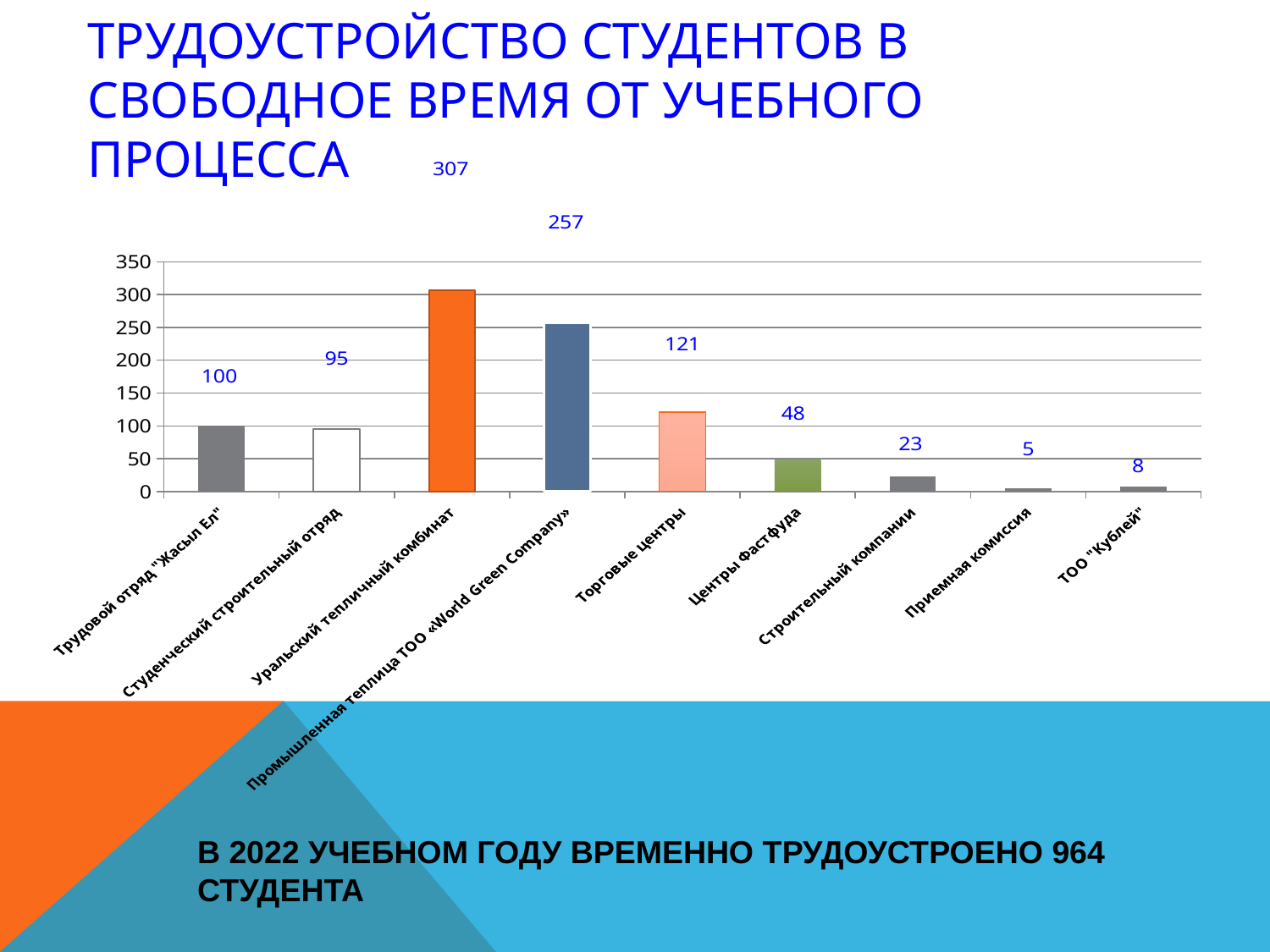
What is the value for Уральский тепличный комбинат? 307 What is the value for Приемная комиссия? 5 What type of chart is shown on the slide? bar chart Which is larger, the value for Трудовой отряд "Жасыл Ел" or the value for Студенческий строительный отряд? Трудовой отряд "Жасыл Ел" What is the difference between the values for Уральский тепличный комбинат and Промышленная теплица ТОО «World Green Company»? 50 What is the highest value shown on the vertical axis? 350 How many categories are plotted in the chart? 9 Which category has the highest value? Уральский тепличный комбинат What is the value for Торговые центры? 121 What is the difference between the values for Торговые центры and Центры Фастфуда? 73 Is the value for Центры Фастфуда greater or less than 50? less Which category has the lowest value? Приемная комиссия